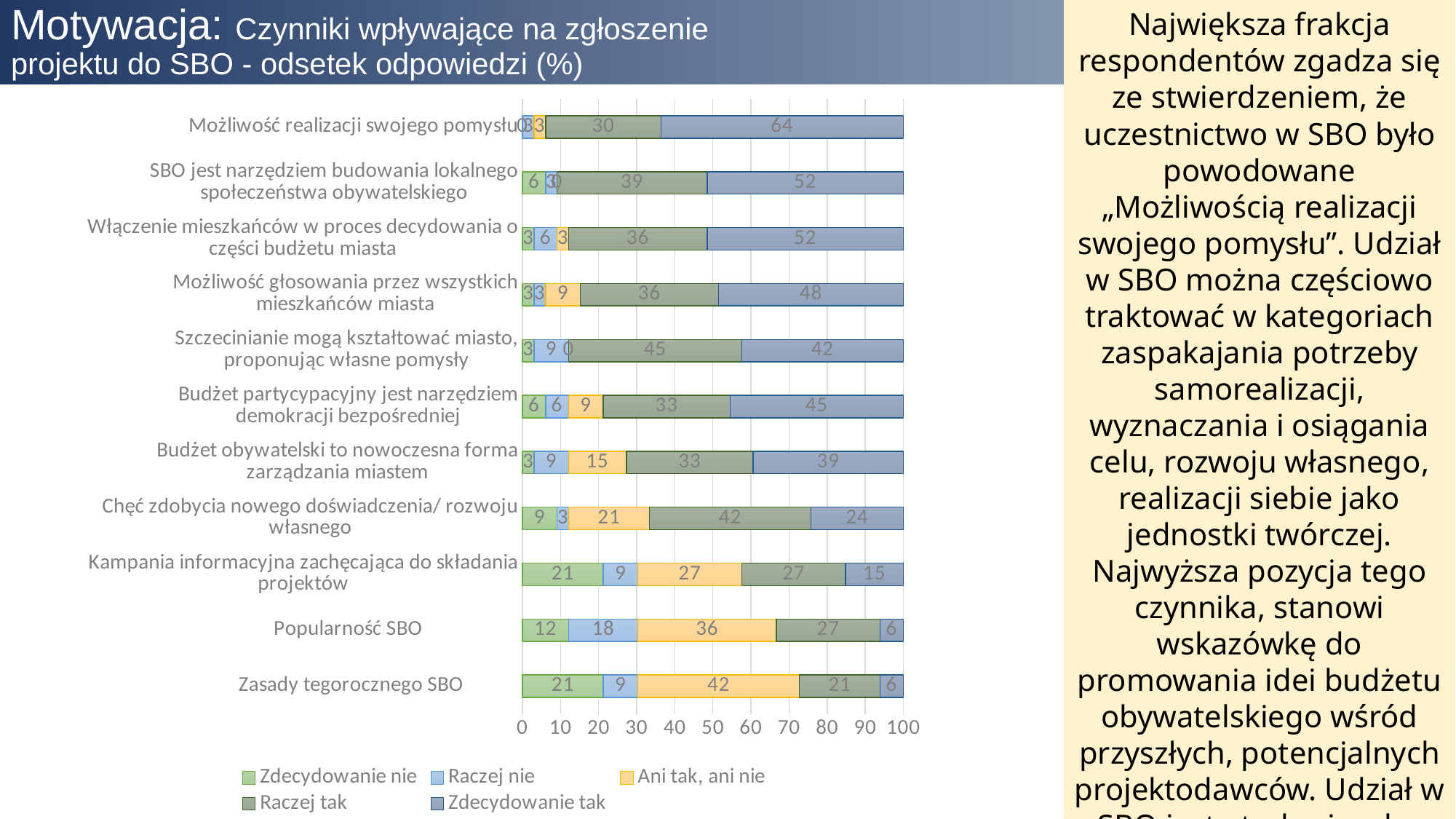
Which category has the highest value for "Zdecydowanie tak"? Możliwość realizacji swojego pomysłu What is the total of the stacked bar for "Popularność SBO"? 99 Which has a larger "Raczej tak" value: "Szczecinianie mogą kształtować miasto, proponując własne pomysły" or "Chęć zdobycia nowego doświadczenia/ rozwoju własnego"? Szczecinianie mogą kształtować miasto, proponując własne pomysły How many categories (statements) are shown in the chart? 11 Which category has the highest value for "Ani tak, ani nie"? Zasady tegorocznego SBO What is the value of "Ani tak, ani nie" for "Zasady tegorocznego SBO"? 42 What is the value of "Zdecydowanie nie" for "Kampania informacyjna zachęcająca do składania projektów"? 21 What is the value of "Ani tak, ani nie" for "Popularność SBO"? 36 What kind of chart is shown on the slide? Stacked bar chart What is the difference between the "Zdecydowanie tak" values for "Możliwość realizacji swojego pomysłu" and "Popularność SBO"? 58 What is the value of "Zdecydowanie tak" for "Możliwość realizacji swojego pomysłu"? 64 How many series does the legend list? 5